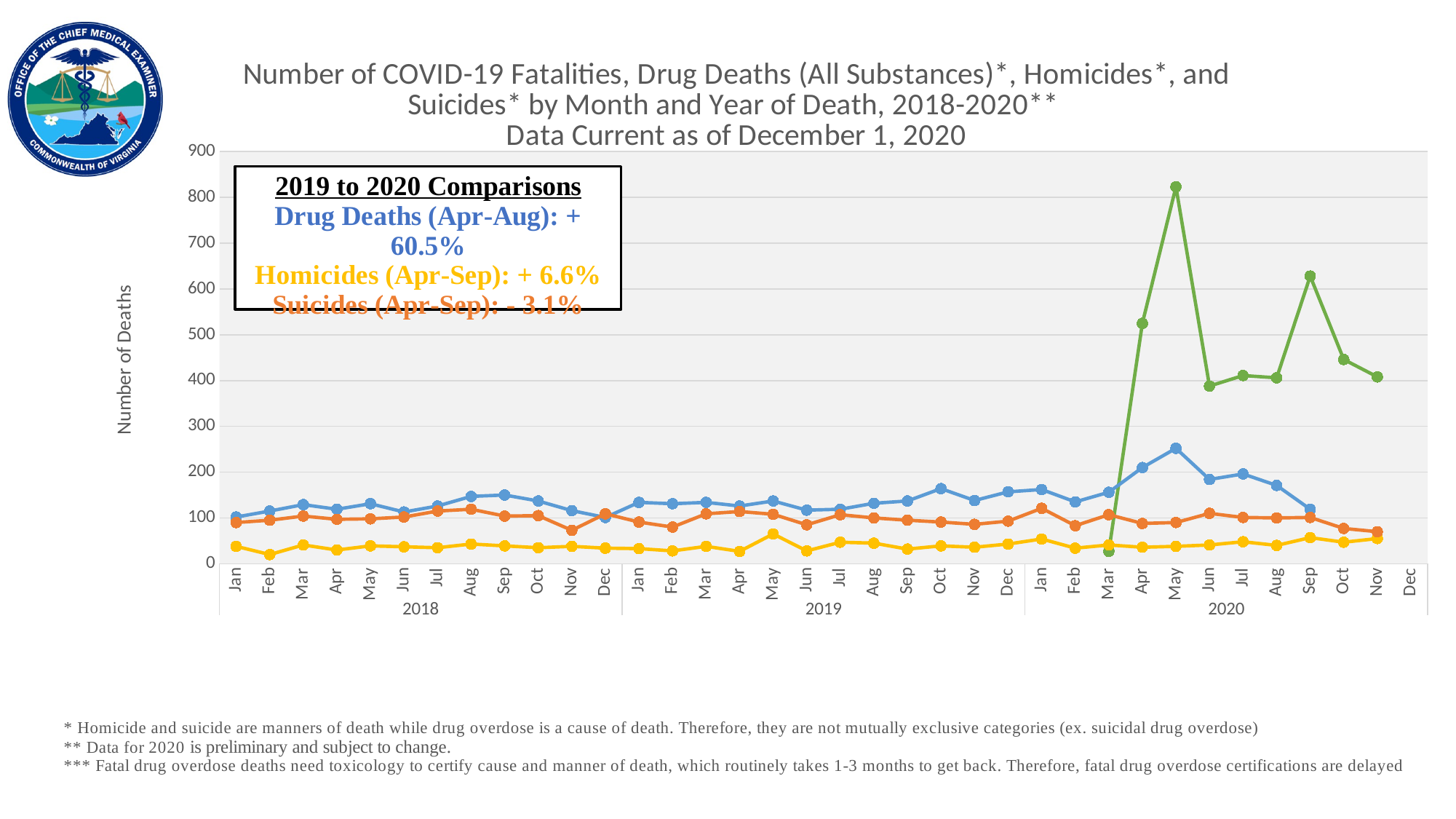
Which is larger: COVID-19 fatalities (green line) in May 2020 or in September 2020? May 2020 According to the comparison box on the chart, what is the 2019 to 2020 change in drug deaths (Apr-Aug)? + 60.5% Does the drug deaths line (blue) rise or fall from March 2020 to May 2020? rise Is the number of homicides (yellow line) in February 2018 greater or less than 100? less Is the number of drug deaths (blue line) in May 2020 greater or less than 200? greater What kind of chart is shown on the slide? line chart Is the number of COVID-19 fatalities (green line) in May 2020 greater or less than 700? greater Which month in 2020 has the highest number of COVID-19 fatalities (green line)? May How many years are shown along the x axis of the chart? 3 Does the COVID-19 fatalities line (green) rise or fall from May 2020 to June 2020? fall